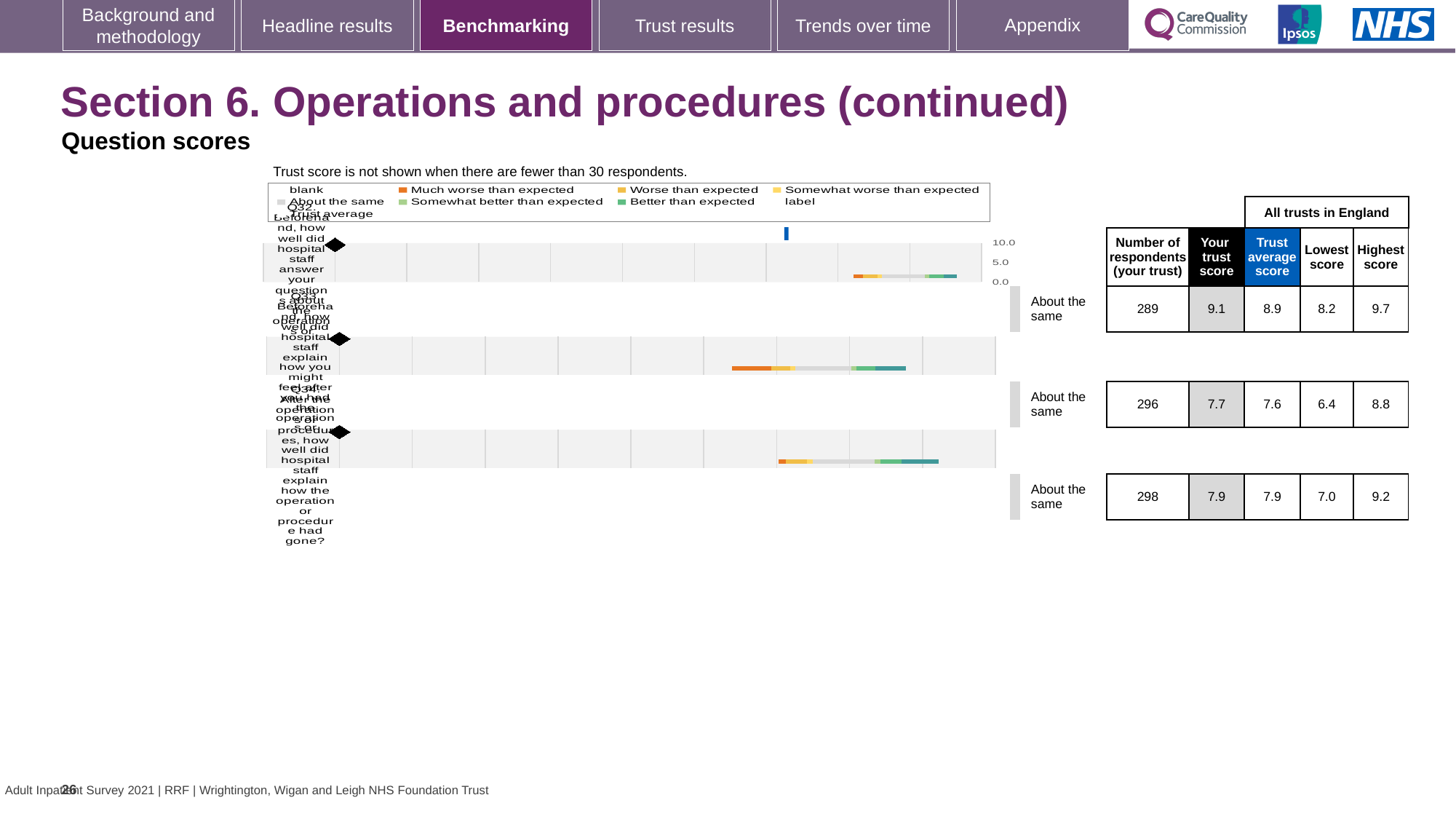
Which of the three questions has the fewest respondents? Q32 What is the lowest score across all trusts in England for Q33, the second row? 6.4 What is the highest score across all trusts in England for Q32, the first row? 9.7 What is the trust average score for Q34, the third row of the chart? 7.9 How many questions (rows) are plotted in the benchmarking chart? 3 What is the trust's score for Q33, the second row of the chart? 7.7 Is the trust score for Q32 (first row) or Q33 (second row) larger? Q32 What benchmark category label is shown next to each of the three question rows? About the same What kind of chart is used to show the question scores on this slide? bar chart What is the number of respondents for Q32, the first row of the chart? 289 Which of the three questions has the highest trust score? Q32 What is the difference between the highest and lowest scores in England for Q34, the third row? 2.2